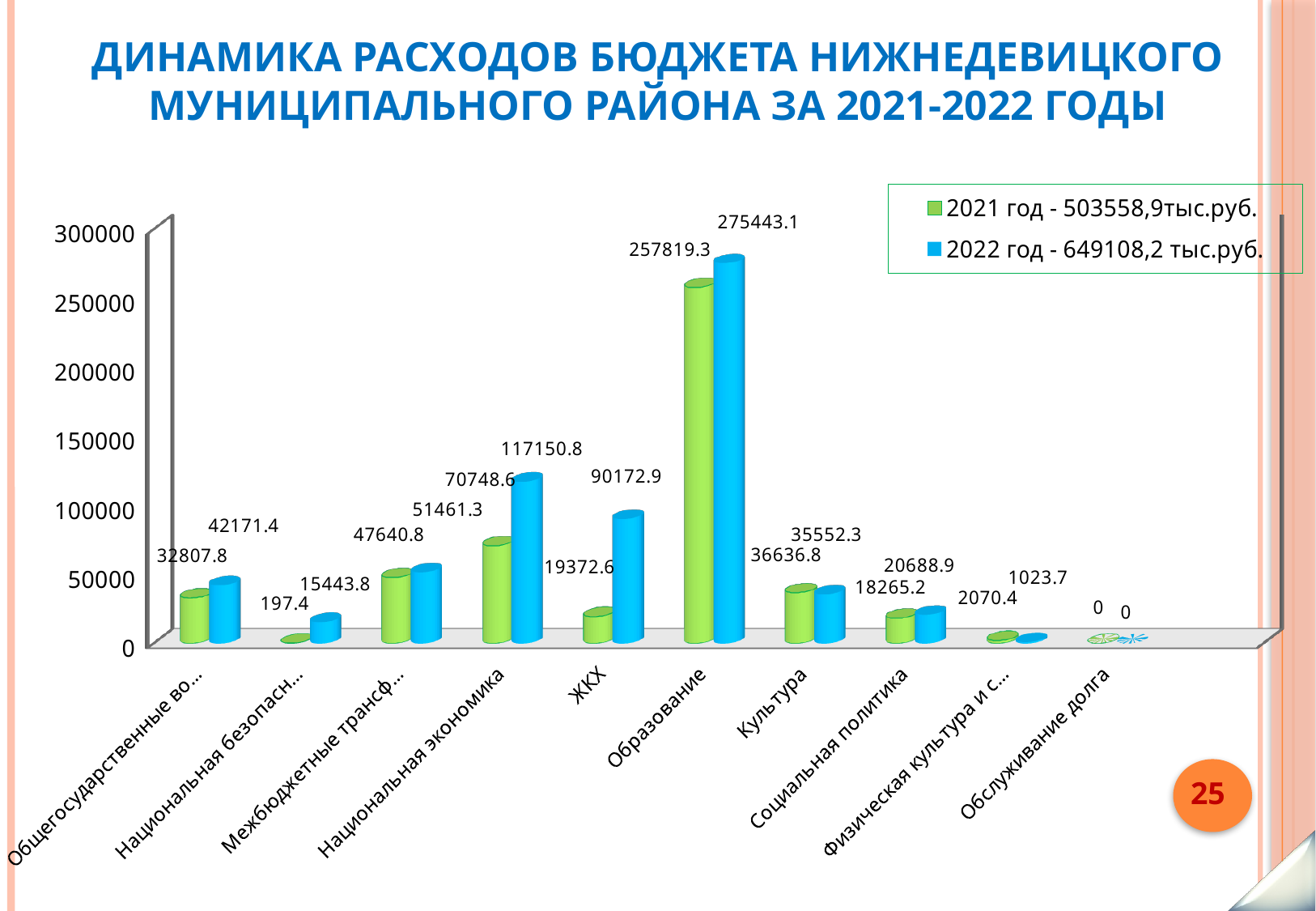
What is the 2022 value for Обслуживание долга? 0 What is the 2021 value for ЖКХ? 19372.6 What is the difference between the 2022 and 2021 values for ЖКХ? 70800.3 How many categories are shown on the x axis? 10 How many series does the legend list? 2 What is the 2021 value for Социальная политика? 18265.2 For Культура, which year has the larger value, 2021 or 2022? 2021 Which category has the highest 2022 value? Образование What is the 2022 value for Образование? 275443.1 What kind of chart is shown on the slide? Bar chart What is the difference between the 2022 and 2021 values for Образование? 17623.8 What is the 2022 value for Национальная экономика? 117150.8